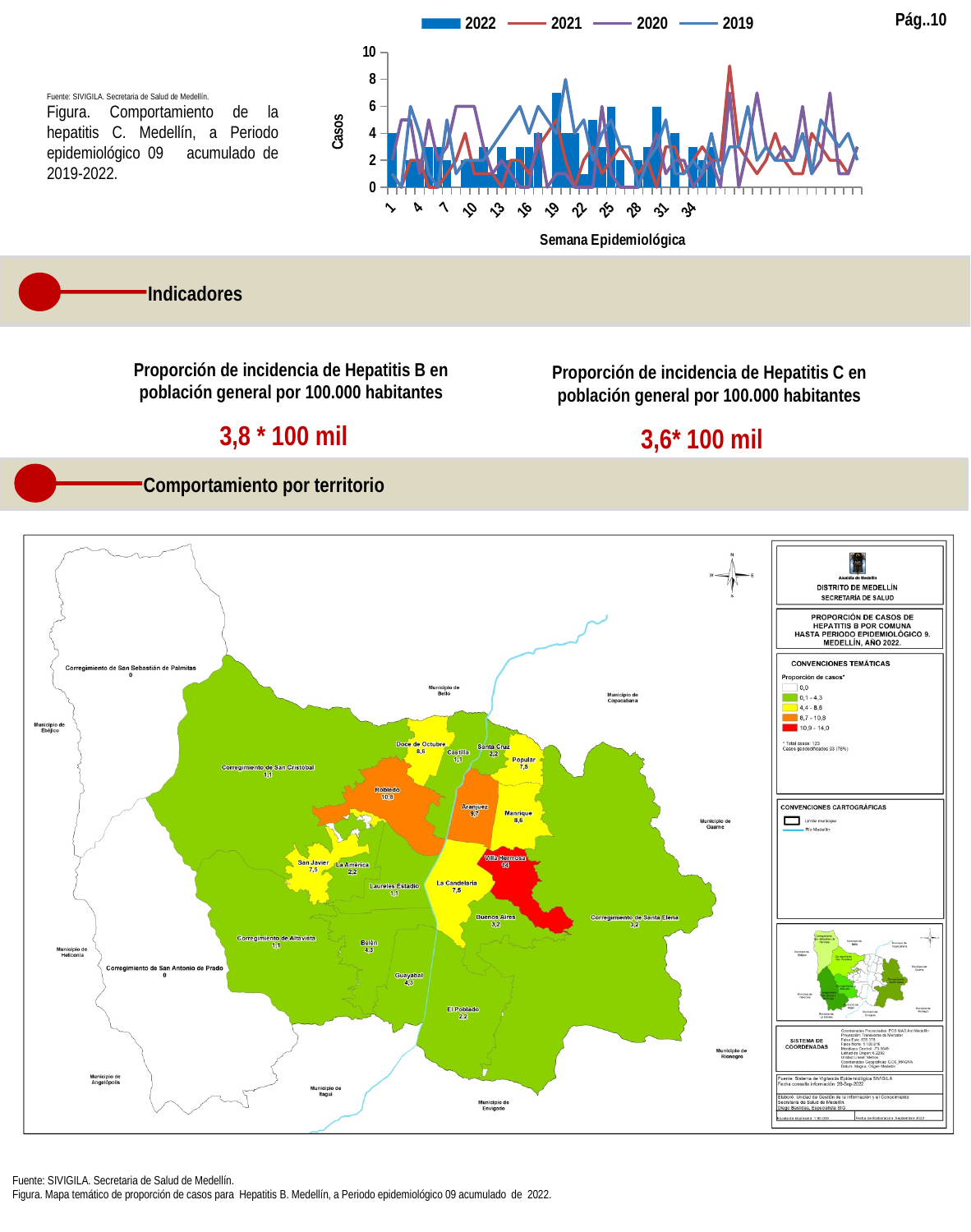
In the hepatitis C chart, is the 2022 bar at week 19 greater or less than 6? greater How many series does the legend of the 'Comportamiento de la hepatitis C' chart list? 4 In the hepatitis C chart, which year's series reaches the highest single weekly value? 2021 In the hepatitis C chart, is the highest value reached by the 2021 line greater or less than 8? greater On the hepatitis B map, which has the larger proportion of cases, Aranjuez or Manrique? Aranjuez What kind of chart is the 'Comportamiento de la hepatitis C' chart at the top of the slide? Combination bar and line chart On the hepatitis B map, what is the proportion of cases shown for Robledo? 10,8 What is the highest tick value shown on the vertical axis of the hepatitis C chart? 10 In the hepatitis C chart, which year is plotted as bars rather than a line? 2022 What is the title of the vertical axis of the hepatitis C chart? Casos On the hepatitis B map, what is the proportion of cases shown for Villa Hermosa? 14 On the hepatitis B map, which comuna has the highest proportion of cases? Villa Hermosa